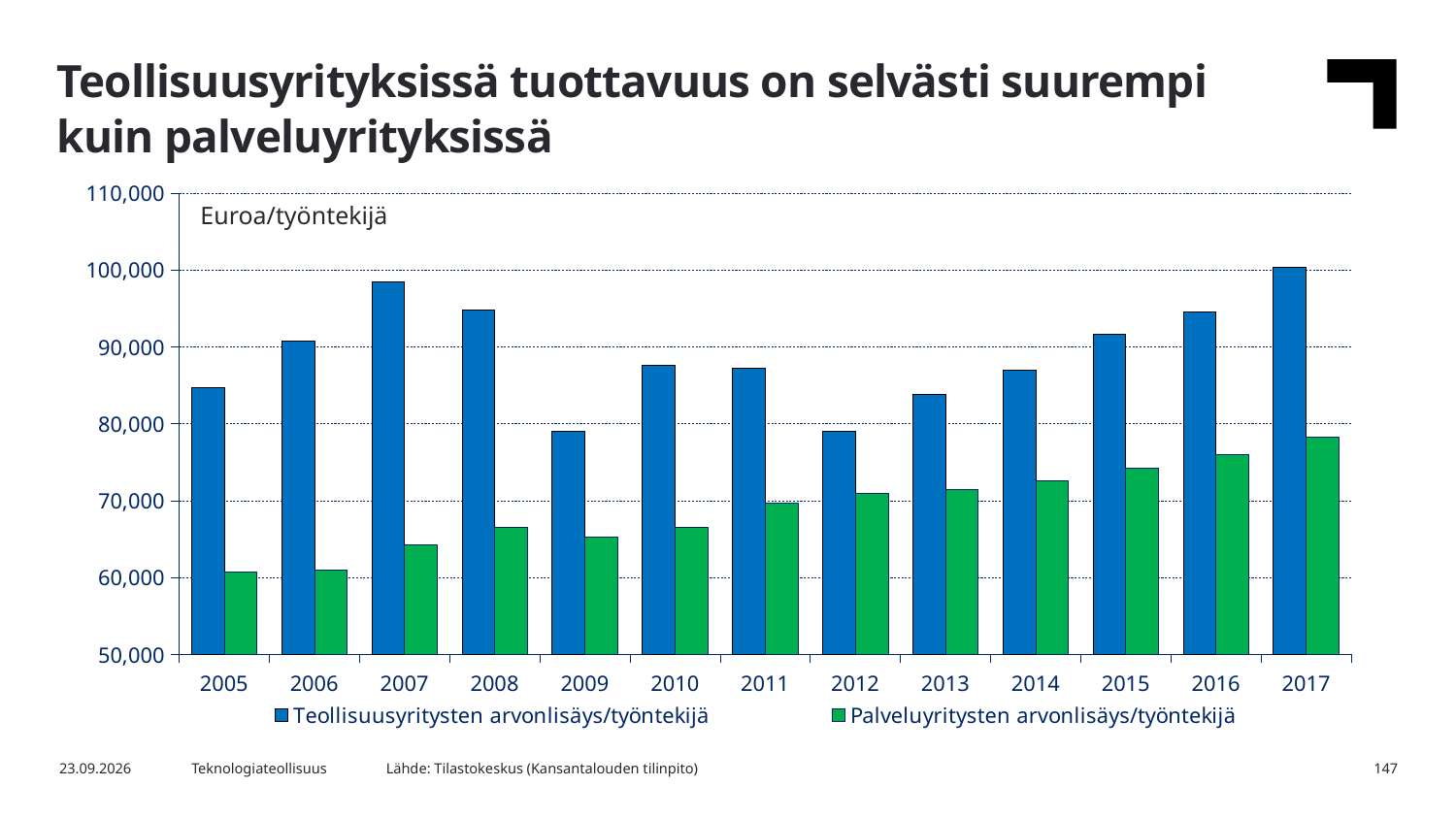
How many years are shown on the x axis? 13 What kind of chart is shown on the slide? bar chart What unit label is shown at the top of the chart's plot area? Euroa/työntekijä Does the value for Palveluyritysten arvonlisäys/työntekijä generally rise or fall from 2005 to 2017? rise Is the value for Palveluyritysten arvonlisäys/työntekijä in 2016 greater or less than 80,000? less Is the value for Palveluyritysten arvonlisäys/työntekijä in 2008 greater or less than 70,000? less In which year is the value for Teollisuusyritysten arvonlisäys/työntekijä highest? 2017 Is the value for Teollisuusyritysten arvonlisäys/työntekijä in 2007 greater or less than 90,000? greater Which is larger for Teollisuusyritysten arvonlisäys/työntekijä: the value in 2007 or in 2008? 2007 How many series does the legend list? 2 In which year is the value for Palveluyritysten arvonlisäys/työntekijä highest? 2017